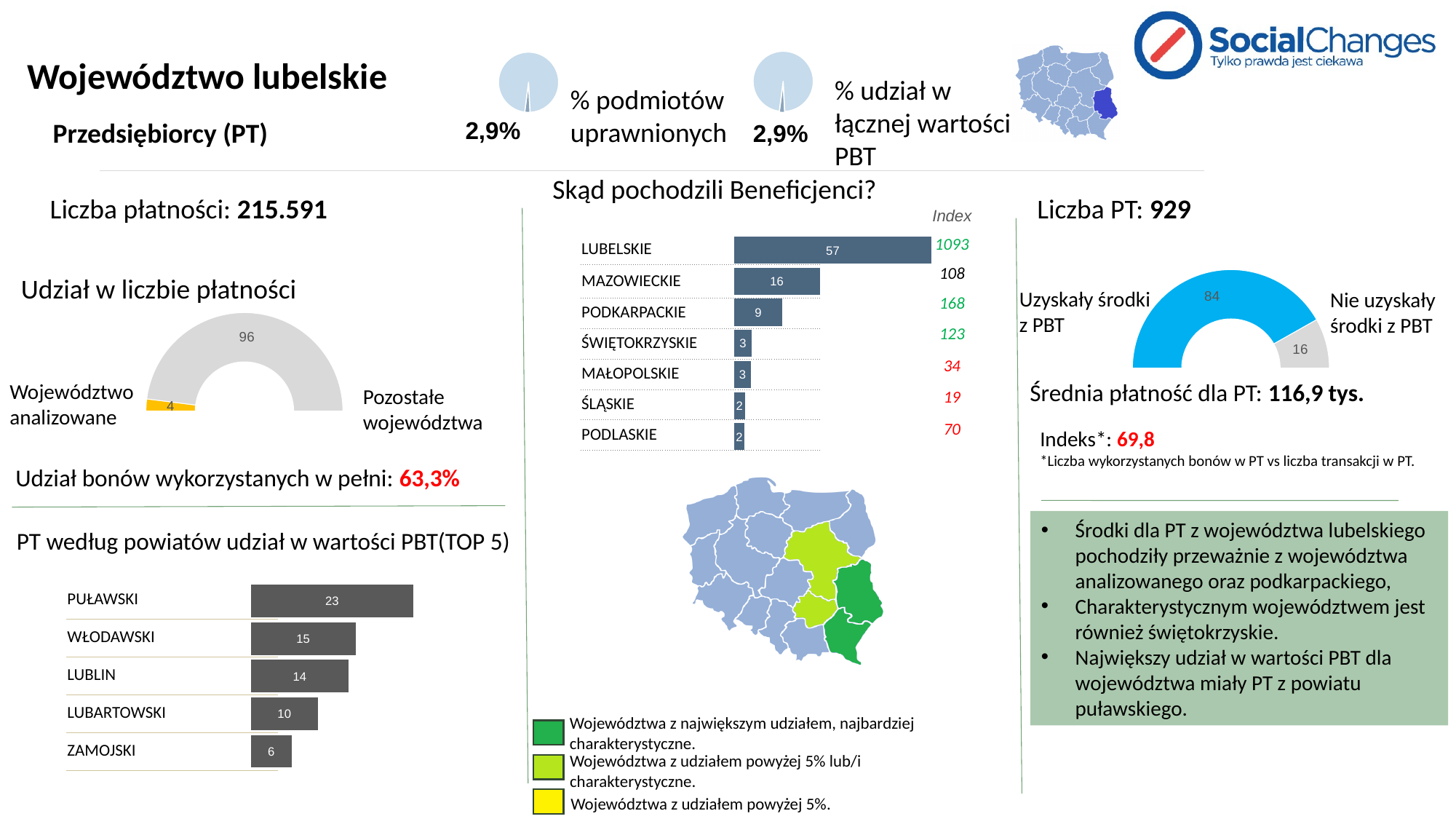
In the 'PT według powiatów udział w wartości PBT(TOP 5)' chart, which is larger: LUBLIN or LUBARTOWSKI? LUBLIN What kind of chart is 'PT według powiatów udział w wartości PBT(TOP 5)'? bar chart In the 'Skąd pochodzili Beneficjenci?' chart, what is the value for PODKARPACKIE? 9 In the 'Liczba PT' chart, what is the value for 'Nie uzyskały środki z PBT'? 16 In the 'Skąd pochodzili Beneficjenci?' chart, which category has the highest value? LUBELSKIE In the 'PT według powiatów udział w wartości PBT(TOP 5)' chart, what is the value for WŁODAWSKI? 15 How many categories are shown in the 'Skąd pochodzili Beneficjenci?' chart? 7 In the 'Liczba PT' chart, what is the difference between 'Uzyskały środki z PBT' and 'Nie uzyskały środki z PBT'? 68 In the 'Skąd pochodzili Beneficjenci?' chart, what is the value for LUBELSKIE? 57 In the 'Udział w liczbie płatności' chart, what is the value for 'Pozostałe województwa'? 96 In the 'PT według powiatów udział w wartości PBT(TOP 5)' chart, which category has the lowest value? ZAMOJSKI In the 'Skąd pochodzili Beneficjenci?' chart, what is the difference between the values for LUBELSKIE and MAZOWIECKIE? 41